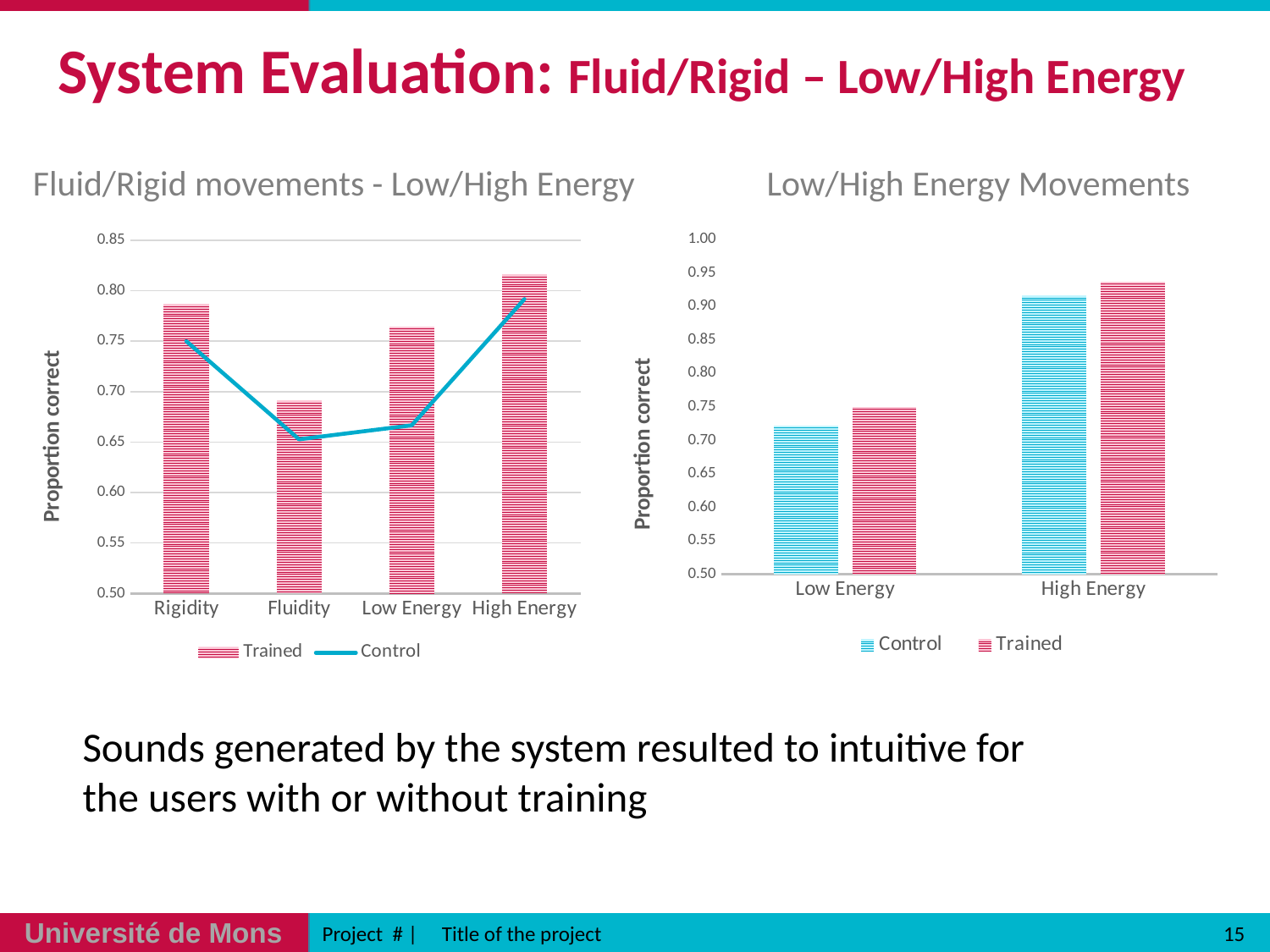
In the left chart titled "Fluid/Rigid movements - Low/High Energy", is the Trained value for High Energy greater or less than 0.80? greater In the right chart titled "Low/High Energy Movements", is the Trained value for High Energy greater or less than 0.90? greater In the left chart titled "Fluid/Rigid movements - Low/High Energy", which category has the lowest Trained bar? Fluidity In the left chart titled "Fluid/Rigid movements - Low/High Energy", which category has the highest Trained bar? High Energy In the right chart titled "Low/High Energy Movements", what kind of chart is it? bar chart In the right chart titled "Low/High Energy Movements", how many series does the legend list? 2 In the left chart titled "Fluid/Rigid movements - Low/High Energy", how many categories are shown on the x axis? 4 In the right chart titled "Low/High Energy Movements", which category has the higher Control value, Low Energy or High Energy? High Energy In the right chart titled "Low/High Energy Movements", is the Control value for Low Energy greater or less than 0.75? less In the left chart titled "Fluid/Rigid movements - Low/High Energy", which series is drawn as a line? Control In the left chart titled "Fluid/Rigid movements - Low/High Energy", how many series does the legend list? 2